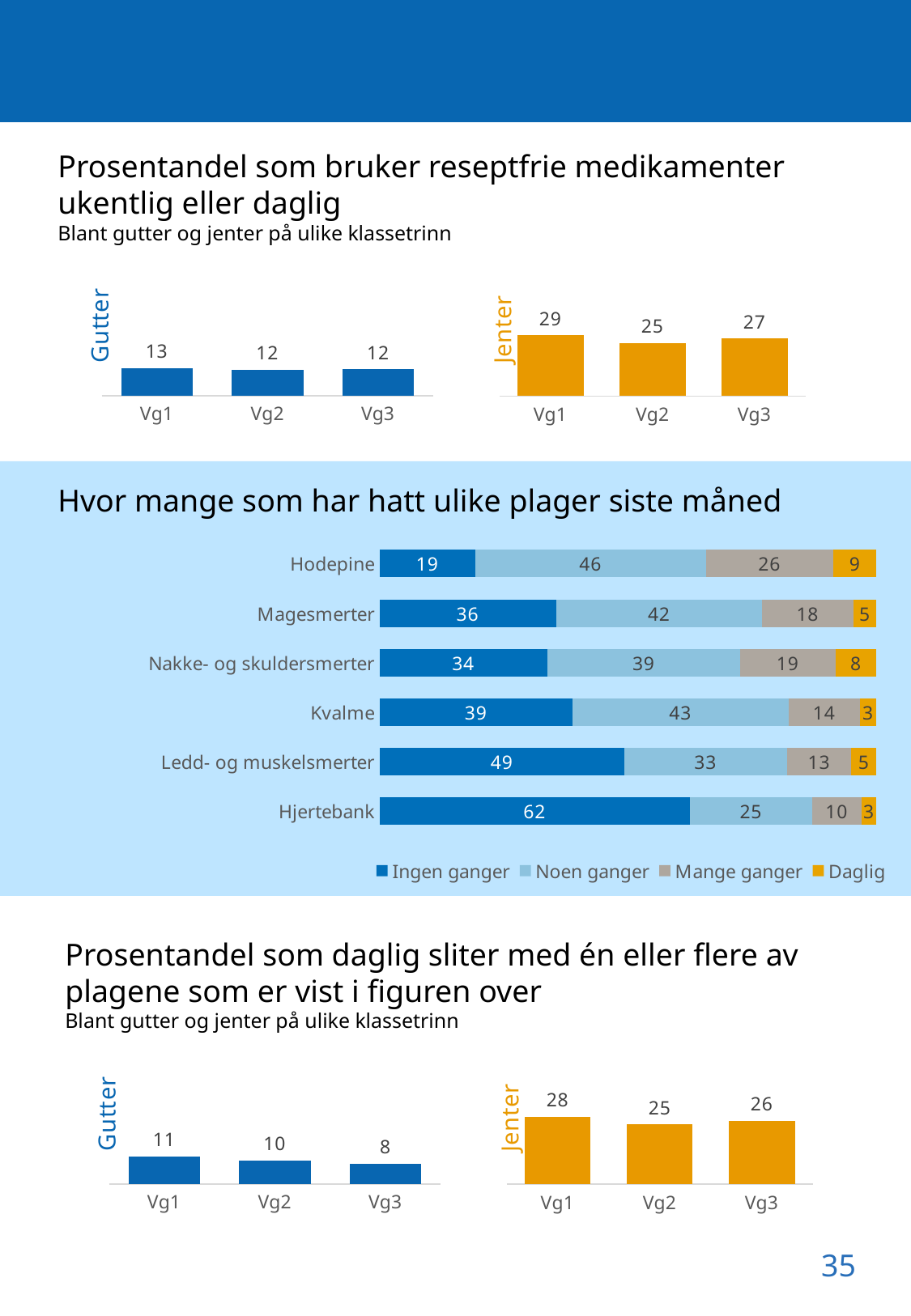
In the middle chart 'Hvor mange som har hatt ulike plager siste måned', which category has the lowest value for 'Ingen ganger'? Hodepine In the middle chart 'Hvor mange som har hatt ulike plager siste måned', what is the value of 'Noen ganger' for Hodepine? 46 In the top chart 'Prosentandel som bruker reseptfrie medikamenter ukentlig eller daglig', what is the difference between Jenter and Gutter in Vg3? 15 In the top chart 'Prosentandel som bruker reseptfrie medikamenter ukentlig eller daglig', which class level has the highest value for Jenter? Vg1 In the bottom chart 'Prosentandel som daglig sliter med én eller flere av plagene', which is larger: Jenter in Vg2 or Jenter in Vg3? Vg3 In the top chart 'Prosentandel som bruker reseptfrie medikamenter ukentlig eller daglig', what is the value for Gutter in Vg1? 13 In the middle chart 'Hvor mange som har hatt ulike plager siste måned', which category has the highest value for 'Ingen ganger'? Hjertebank In the middle chart 'Hvor mange som har hatt ulike plager siste måned', how many categories are shown? 6 In the bottom chart 'Prosentandel som daglig sliter med én eller flere av plagene', do the values for Gutter rise or fall from Vg1 to Vg3? Fall What kind of chart is the middle chart 'Hvor mange som har hatt ulike plager siste måned'? Stacked bar chart In the middle chart 'Hvor mange som har hatt ulike plager siste måned', how many series does the legend list? 4 In the middle chart 'Hvor mange som har hatt ulike plager siste måned', what is the total of the stacked bar for Kvalme? 99